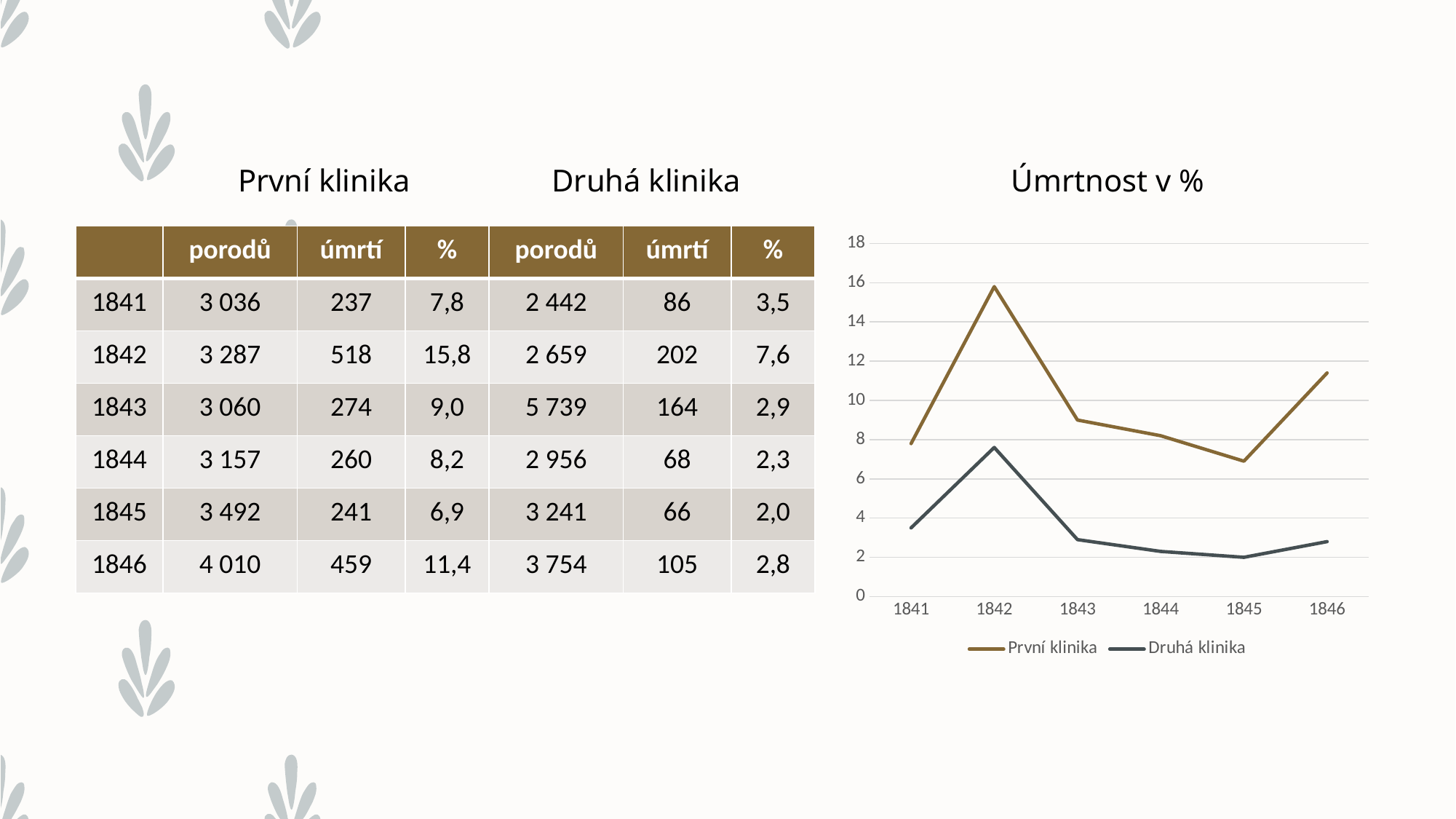
What kind of chart is shown under the title "Úmrtnost v %"? line chart What is the title of the line chart on the right of the slide? Úmrtnost v % In the "Úmrtnost v %" chart, is the value for Druhá klinika in 1844 greater or less than 4? less How many series does the legend of the "Úmrtnost v %" chart list? 2 In the "Úmrtnost v %" chart, does the Druhá klinika line rise or fall from 1842 to 1845? falls In the "Úmrtnost v %" chart, which series has the higher value in 1842, První klinika or Druhá klinika? První klinika In the "Úmrtnost v %" chart, in which year does the Druhá klinika line reach its lowest value? 1845 According to the table on the slide, what is the mortality percentage for První klinika in 1842 that is plotted in the "Úmrtnost v %" chart? 15,8 In the "Úmrtnost v %" chart, does the První klinika line rise or fall from 1845 to 1846? rises In the "Úmrtnost v %" chart, in which year does the První klinika line reach its highest value? 1842 In the "Úmrtnost v %" chart, is the value for První klinika in 1842 greater or less than 14? greater How many years are plotted along the x axis of the "Úmrtnost v %" chart? 6